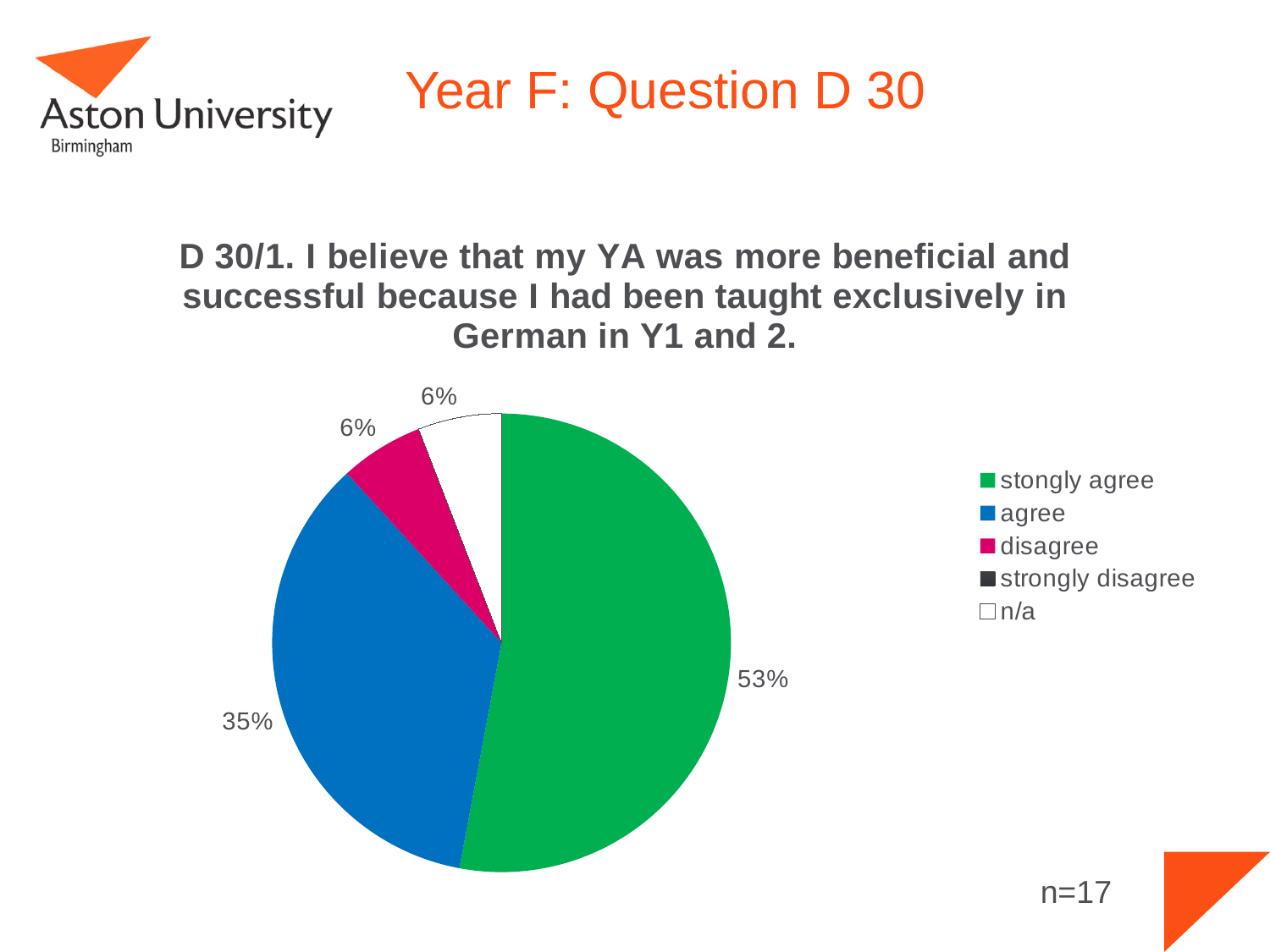
What percentage of the pie chart is labelled for the 'n/a' slice? 6% How many response categories does the legend list? 5 What kind of chart is shown on the slide? pie chart What is the combined share of the 'strongly agree' and 'agree' slices? 88% What colour is the 'agree' slice in the pie chart? blue What is the difference in percentage points between the 'strongly agree' and 'agree' slices? 18 Which slice is larger, 'agree' or 'disagree'? agree What percentage of the pie chart is labelled for the 'agree' slice? 35% What is the sample size (n) stated on the slide? n=17 What percentage of the pie chart is labelled for the 'disagree' slice? 6% Which response category has the largest share of the pie chart? stongly agree What percentage of the pie chart is labelled for the 'strongly agree' slice? 53%